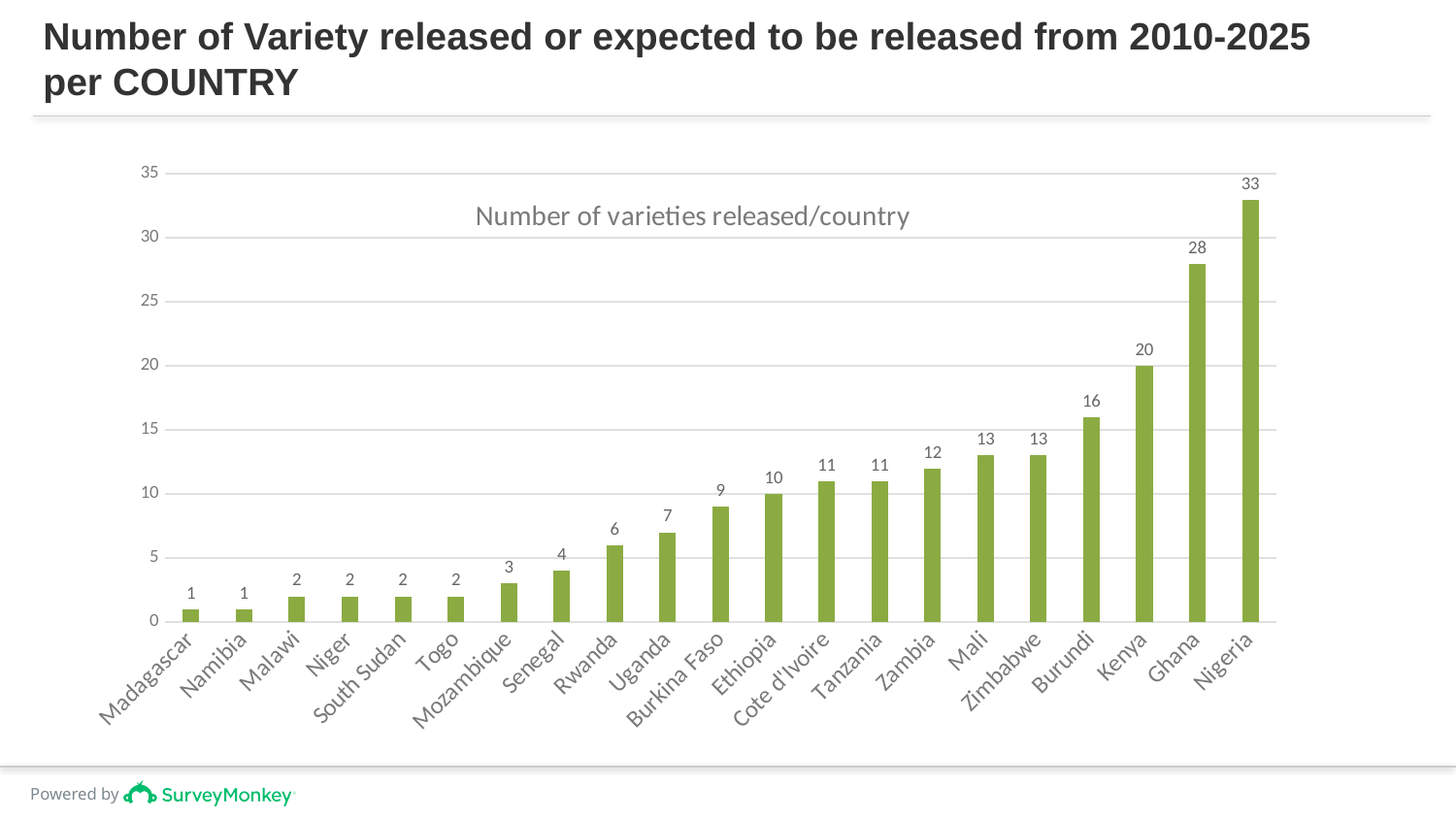
What is the value for Kenya? 20 What kind of chart is shown on the slide? Bar chart What is the title printed inside the chart area? Number of varieties released/country Do the values rise or fall moving from left to right along the x axis? Rise How many varieties were released for Burkina Faso? 9 Which country has the highest number of varieties released? Nigeria What is the value shown for Mozambique? 3 Is the value for Ghana greater or less than 25? greater How many countries are shown on the x axis? 21 What is the difference between the values for Burundi and Zambia? 4 Which is larger, the value for Ethiopia or the value for Rwanda? Ethiopia What is the difference between the values for Nigeria and Ghana? 5